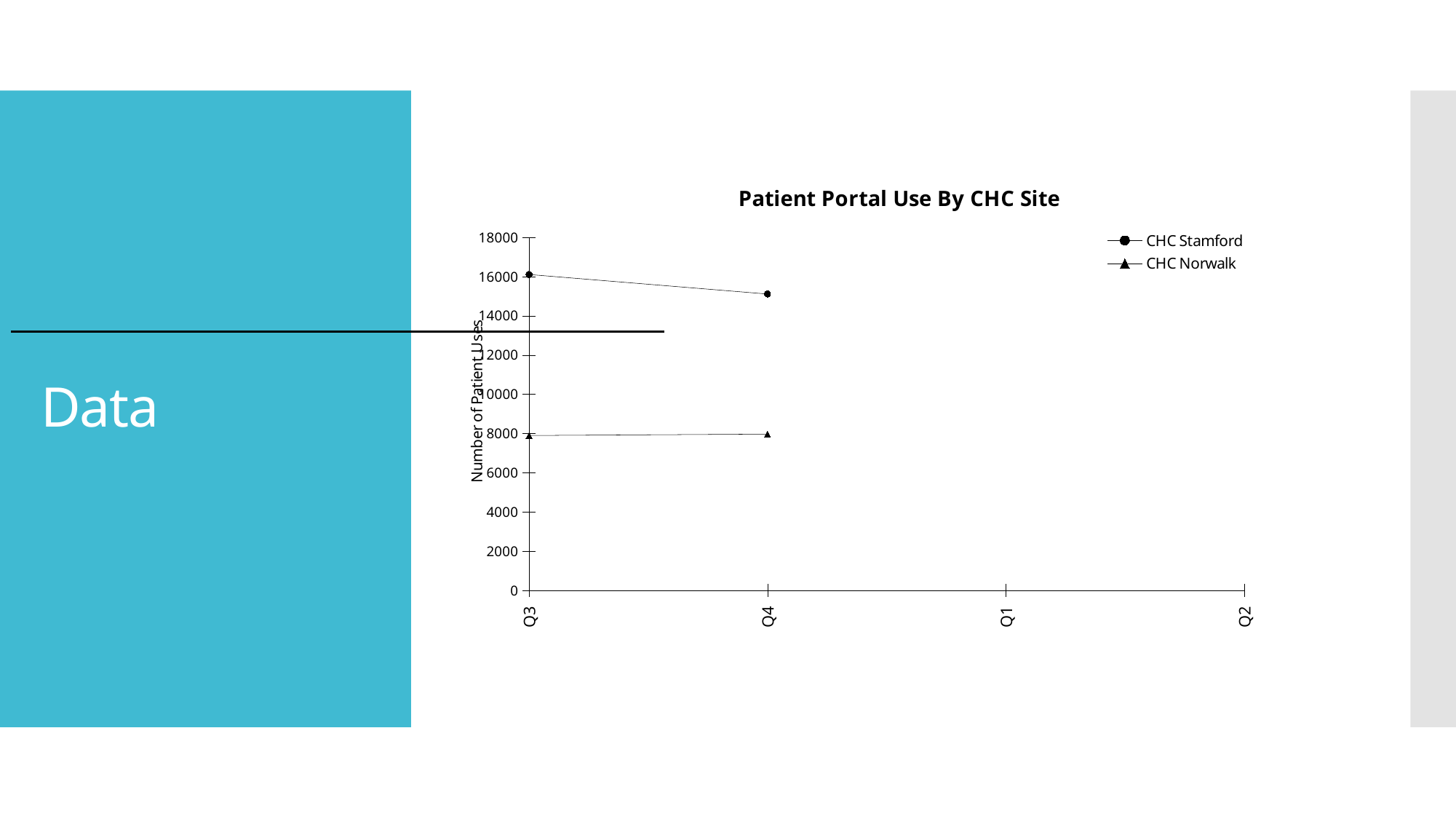
How many categories are shown on the x axis? 4 Is the value for CHC Stamford at Q3 greater or less than 14000? greater Does the value for CHC Stamford rise or fall from Q3 to Q4? Fall Which series has the higher value at Q4, CHC Stamford or CHC Norwalk? CHC Stamford What kind of chart is shown on the slide? Line chart What is the label of the vertical axis? Number of Patient Uses Is the value for CHC Stamford at Q4 greater or less than 16000? less What is the title of the chart? Patient Portal Use By CHC Site Which series has the higher value at Q3, CHC Stamford or CHC Norwalk? CHC Stamford Is the value for CHC Norwalk at Q3 greater or less than 10000? less How many series does the legend list? 2